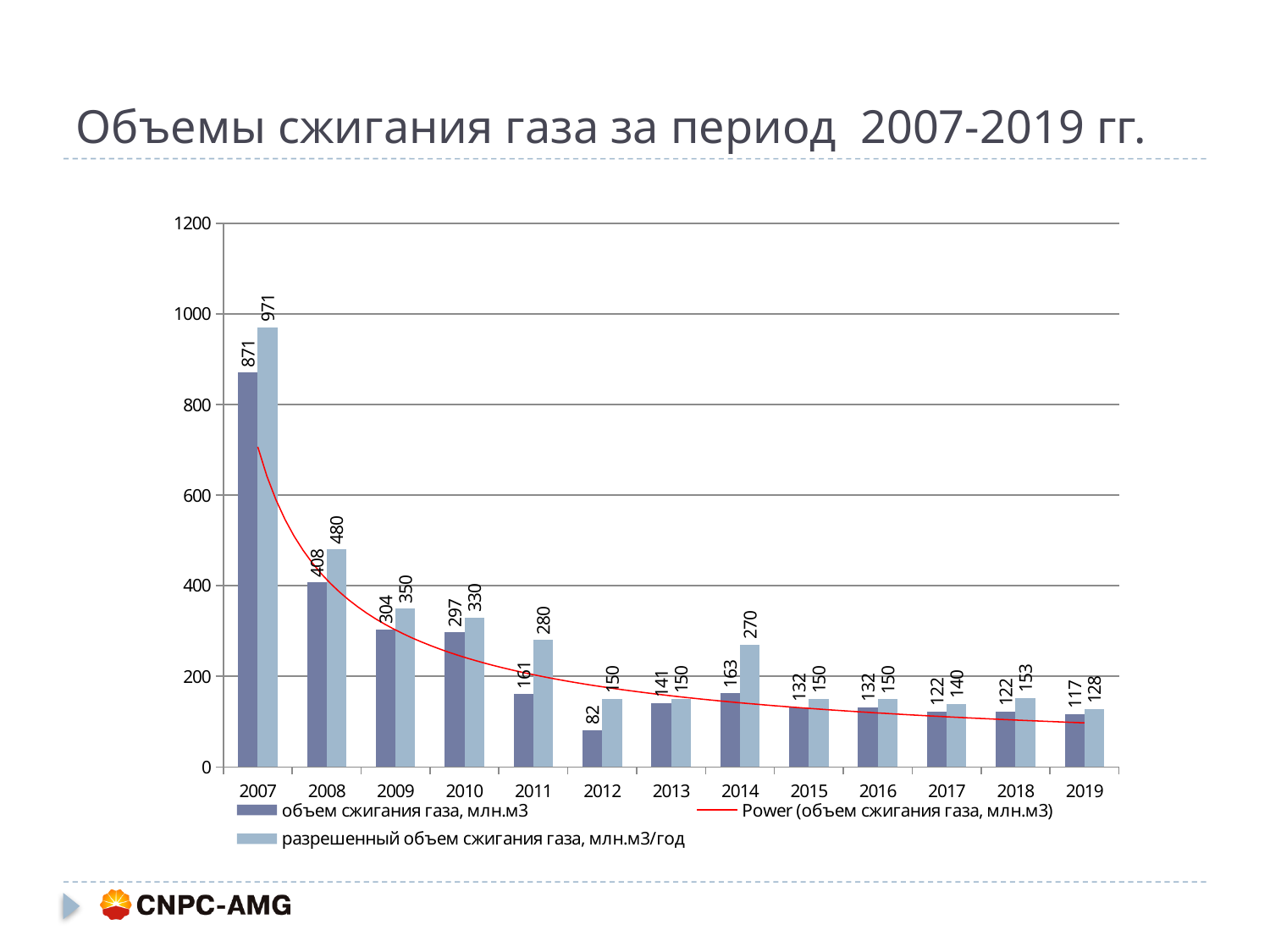
How many entries does the legend list? 3 Does "объем сжигания газа, млн.м3" generally rise or fall from 2007 to 2019? fall What is the value of "объем сжигания газа, млн.м3" for 2007? 871 What is the value of "разрешенный объем сжигания газа, млн.м3/год" for 2014? 270 Is the value of "объем сжигания газа, млн.м3" for 2008 greater or less than 600? less What is the value of "объем сжигания газа, млн.м3" for 2012? 82 Which is larger in 2019: "объем сжигания газа, млн.м3" or "разрешенный объем сжигания газа, млн.м3/год"? разрешенный объем сжигания газа, млн.м3/год Which year has the lowest value of "объем сжигания газа, млн.м3"? 2012 What kind of chart is shown on the slide? bar chart Which year has the highest value of "разрешенный объем сжигания газа, млн.м3/год"? 2007 How many years are shown on the x axis? 13 What is the difference between "разрешенный объем сжигания газа, млн.м3/год" and "объем сжигания газа, млн.м3" in 2011? 119